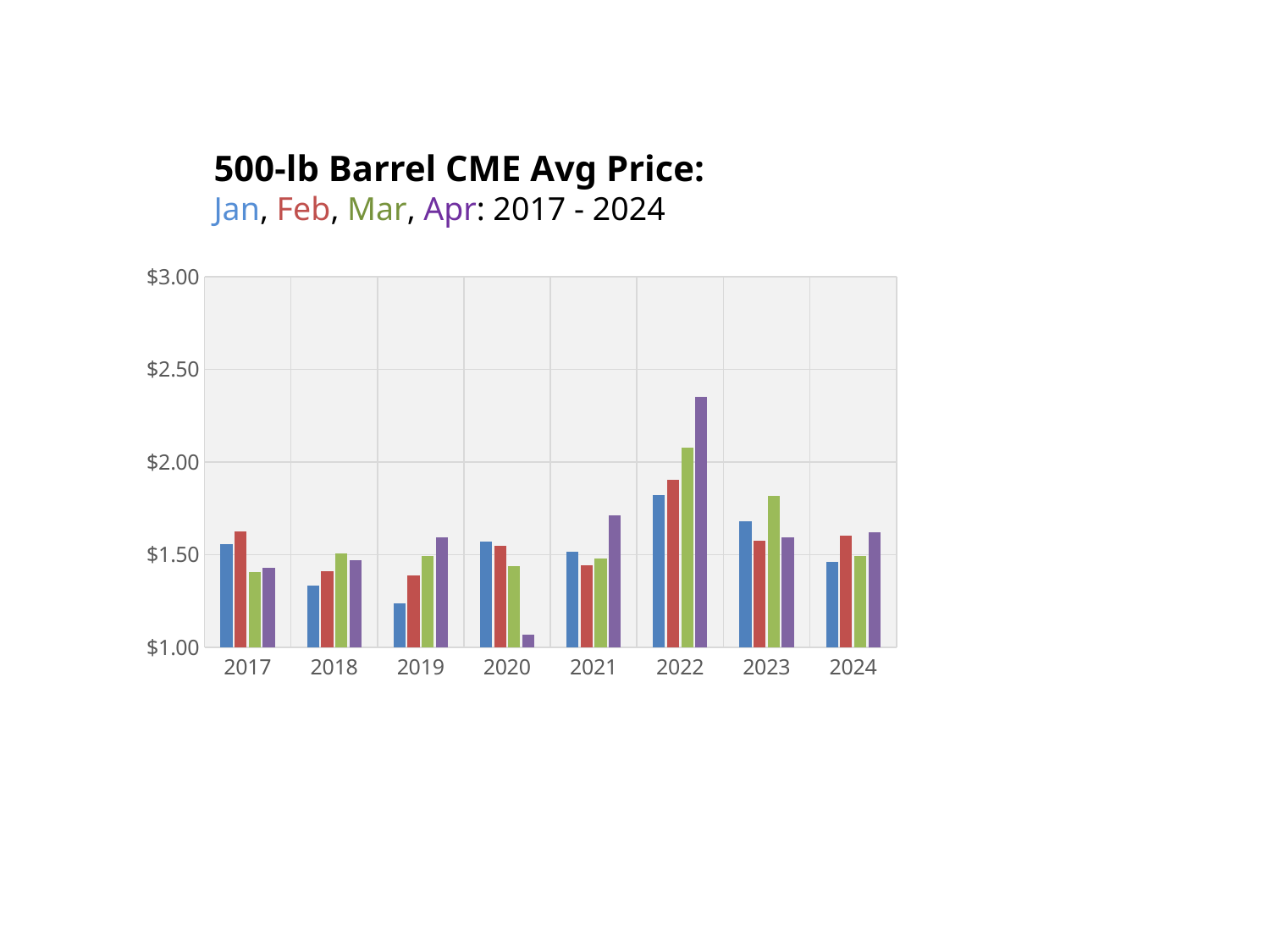
In 2023, which month has the highest bar? Mar How many years are shown along the x axis? 8 In 2019, which month has the lowest bar? Jan Is the Apr value for 2022 greater or less than $2.00? greater Is the Jan value for 2019 greater or less than $1.50? less How many months (series) does the chart title list? 4 What kind of chart is shown on the slide? bar chart Is the Apr value for 2020 greater or less than $1.50? less Which year has the highest Apr bar? 2022 Which year has the lowest Apr bar? 2020 Which is larger, the Jan value for 2022 or the Jan value for 2017? 2022 What colour represents Apr in the chart? purple